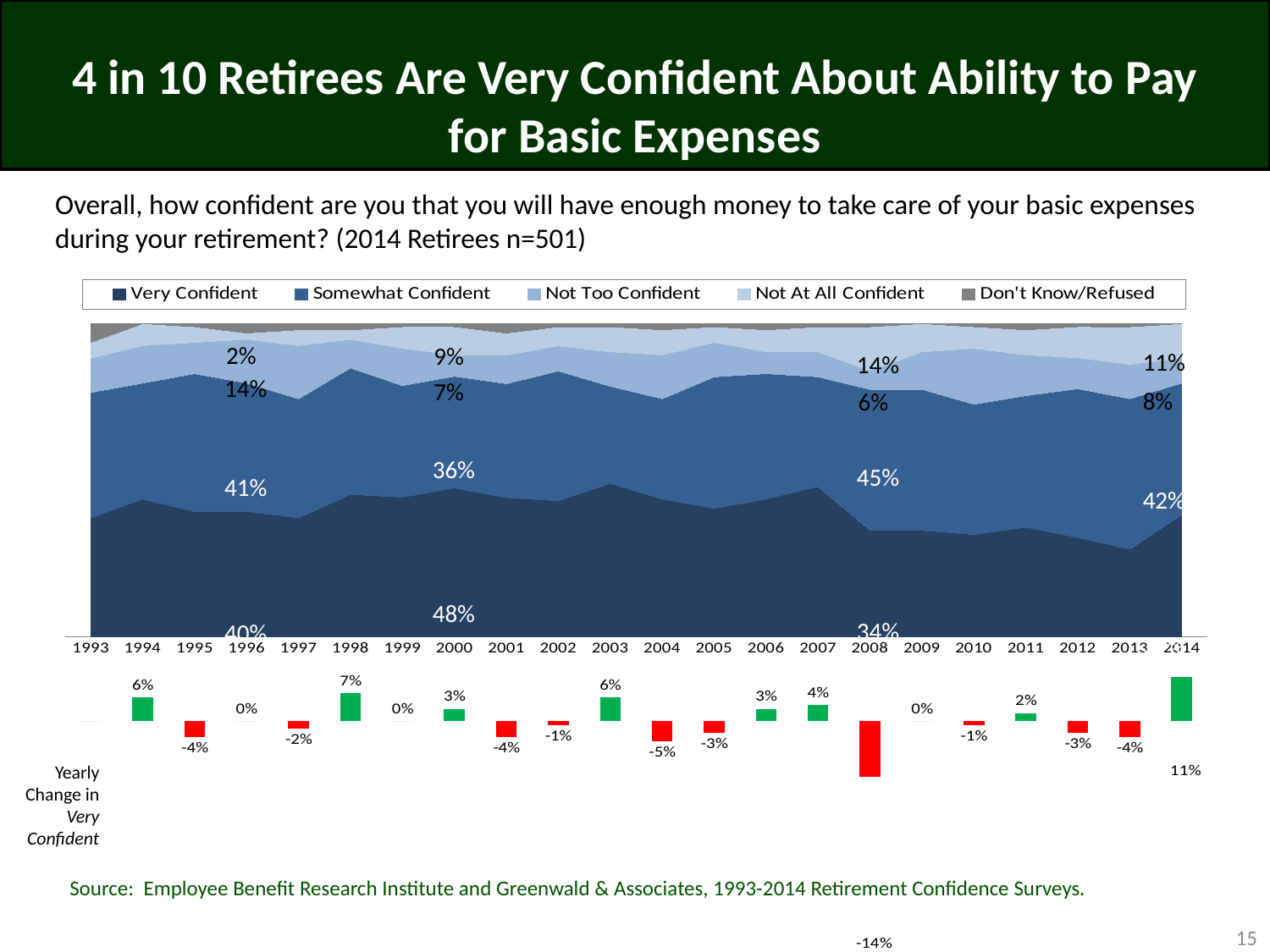
How many years are shown along the x axis of the top chart? 22 In the bottom chart of yearly change in Very Confident, which year has the lowest value? 2008 In the top chart, what percentage of retirees were Not At All Confident in 1996? 2% In the top chart, what percentage of retirees were Very Confident in 2000? 48% In the bottom chart of yearly change in Very Confident, what is the value for 1998? 7% How many series does the legend of the top chart list? 5 In the bottom chart of yearly change in Very Confident, which year has the highest value? 2014 In the top chart, what percentage of retirees were Not Too Confident in 2014? 8% In the top chart, what percentage of retirees were Somewhat Confident in 2008? 45% In the bottom chart of yearly change in Very Confident, which year has the larger value, 2003 or 2007? 2003 In the top chart, what is the difference between the Very Confident share in 2000 and in 2008? 14 percentage points What kind of chart is the top chart showing confidence levels from 1993 to 2014? Stacked area chart